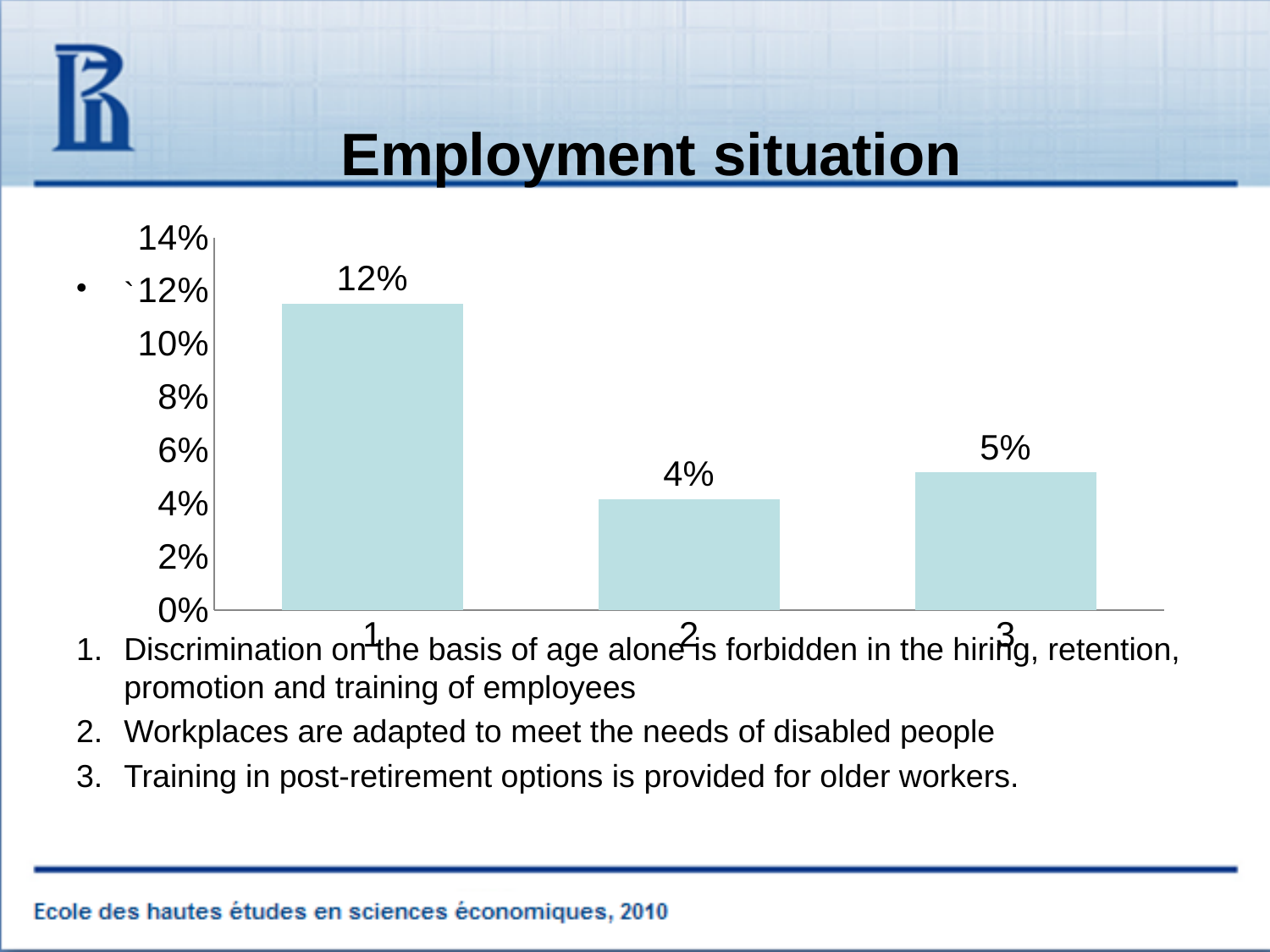
What is the value for category 1? 12% How many bars are shown in the chart? 3 What is the value for category 3? 5% Which category has the lowest value? 2 Is the value for category 1 greater or less than 10%? greater What is the value for category 2? 4% What is the difference between the values for category 3 and category 2? 1% What is the title of the slide containing the chart? Employment situation Which category has the highest value? 1 Which is larger, the value for category 1 or category 3? 1 What kind of chart is shown on the slide? bar chart What is the difference between the values for category 1 and category 2? 8%